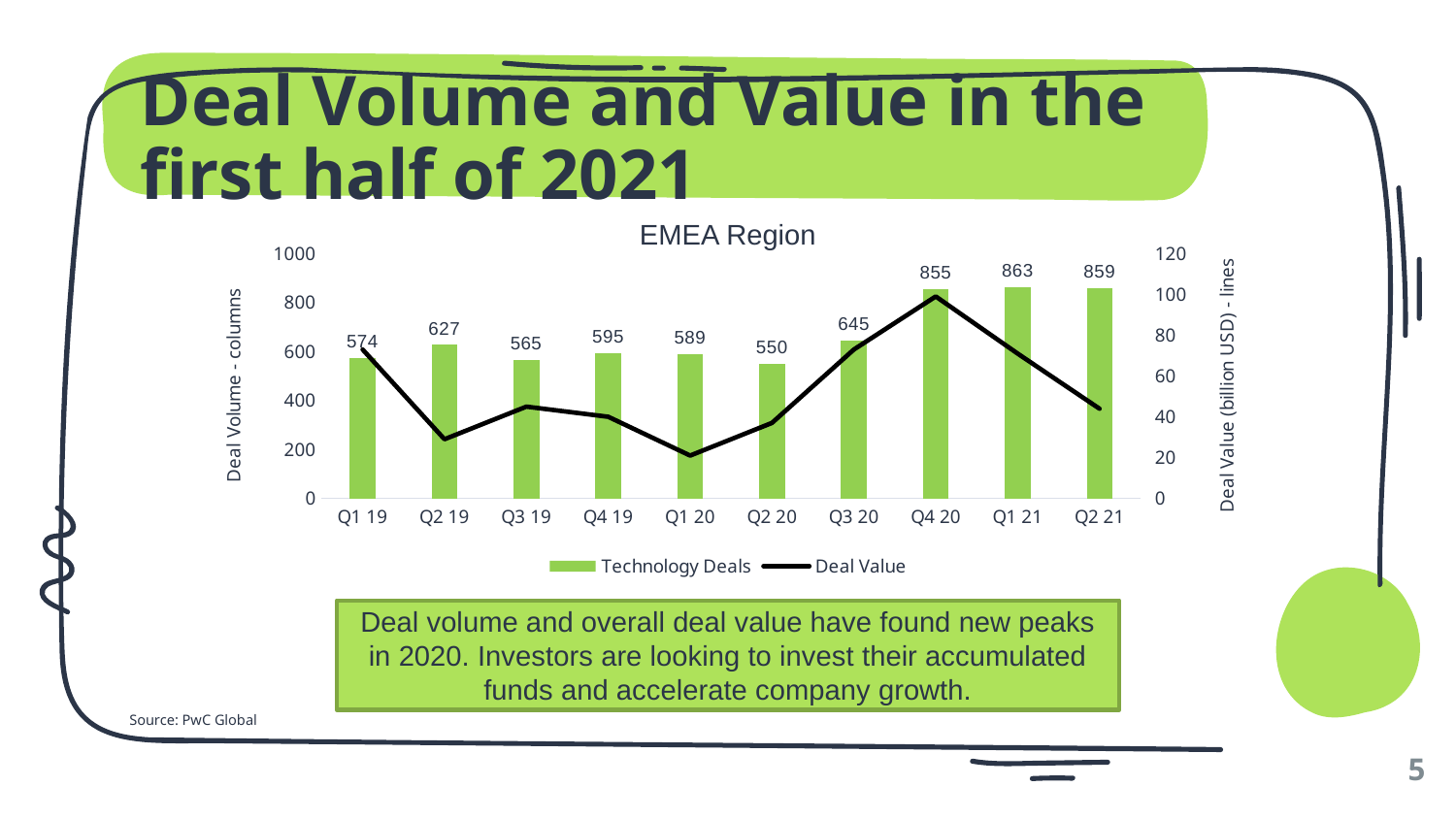
Is the Deal Value for Q4 20 greater or less than 80 billion USD? greater What kind of chart is used to show Technology Deals? Bar chart Which quarter has the highest number of Technology Deals? Q1 21 Which quarter has the lowest number of Technology Deals? Q2 20 How many quarters are shown on the x axis of the chart? 10 What is the difference in Technology Deals between Q4 20 and Q3 20? 210 What is the title of the chart? EMEA Region Which quarter had more Technology Deals, Q4 19 or Q1 20? Q4 19 What is the number of Technology Deals in Q4 20? 855 Is the Deal Value for Q1 20 greater or less than 40 billion USD? less What is the number of Technology Deals in Q2 19? 627 How many series does the legend list? 2